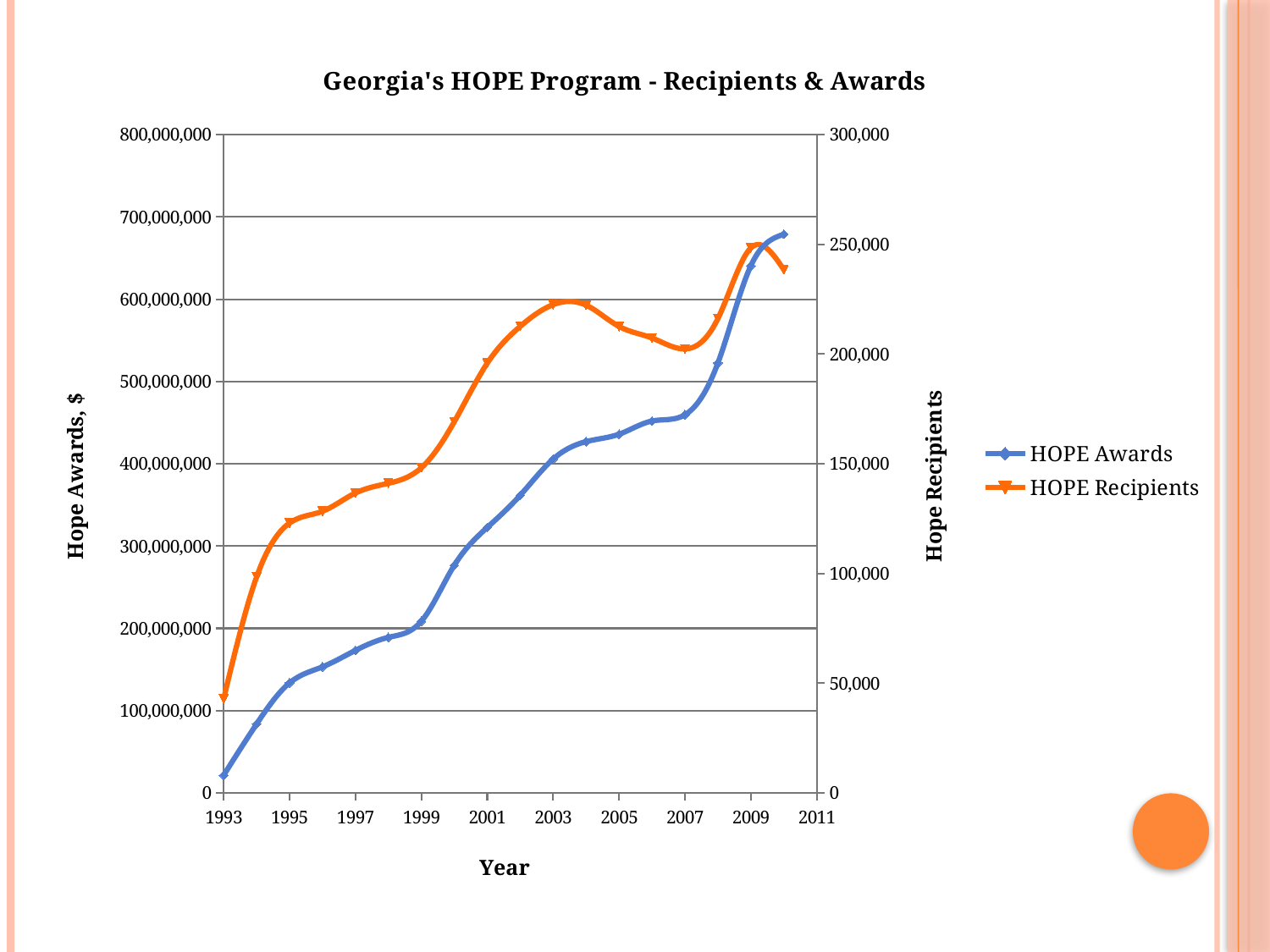
In which year is the HOPE Awards value lowest? 1993 What is the title of the chart? Georgia's HOPE Program - Recipients & Awards What kind of chart is shown on the slide? line chart In which year is the HOPE Recipients value highest? 2009 How many series does the legend list? 2 Does the HOPE Recipients line rise or fall between 2003 and 2007? fall What is the label of the left vertical axis? Hope Awards, $ Is the HOPE Recipients value for 2003 greater or less than 200,000? greater Is the HOPE Awards value for 1993 greater or less than 100,000,000? less Does the HOPE Awards line generally rise or fall from 1993 to 2010? rise Is the HOPE Awards value for 2010 greater or less than 600,000,000? greater In which year is the HOPE Awards value highest? 2010